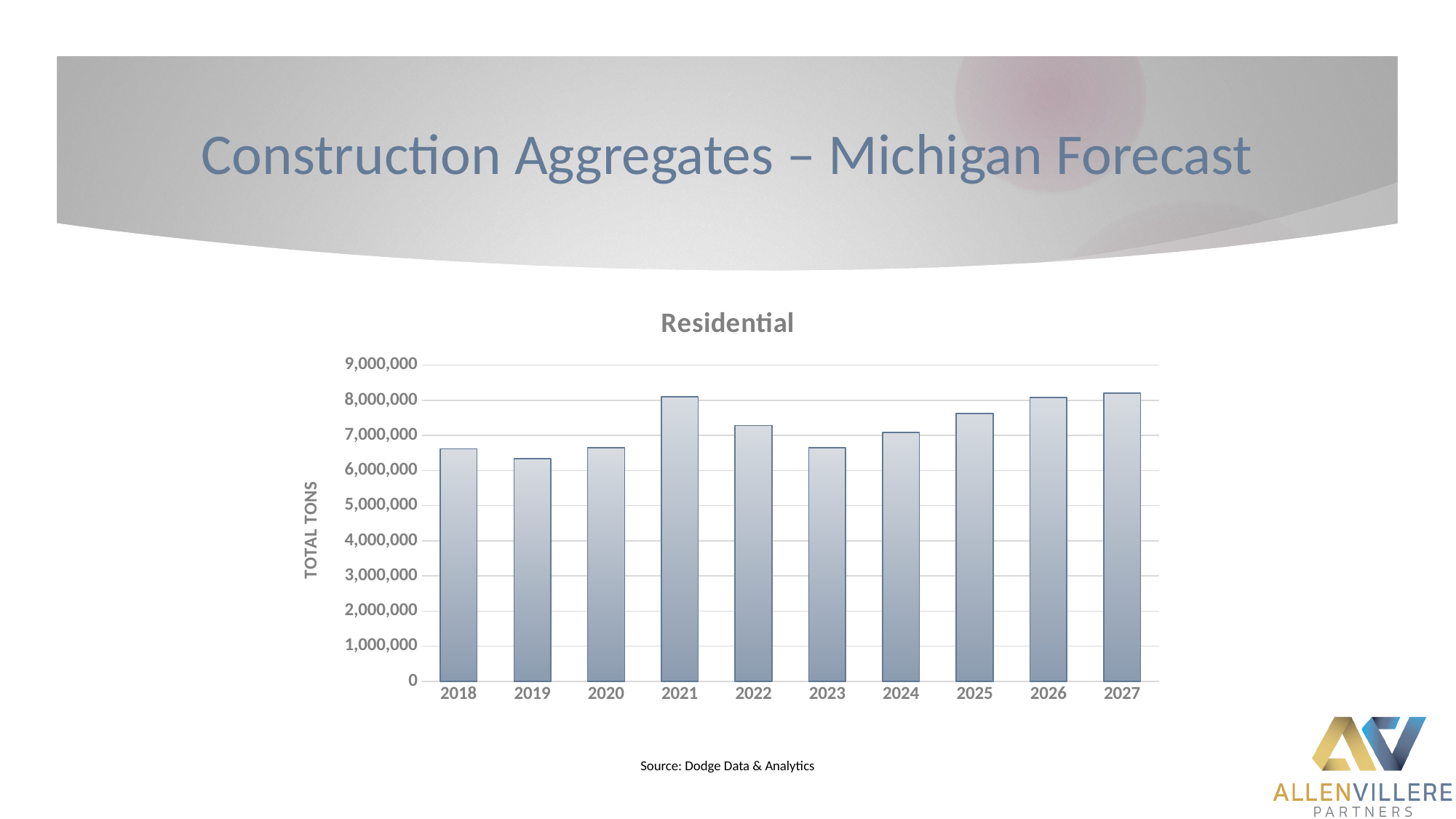
Is the value for 2025 greater or less than 7,000,000? greater Is the value for 2027 greater or less than 8,000,000? greater Is the value for 2019 greater or less than 7,000,000? less Do the values rise or fall from 2023 to 2027? rise Which is larger, the value for 2021 or the value for 2022? 2021 Which year has the lowest value in the Residential chart? 2019 Which is larger, the value for 2019 or the value for 2020? 2020 What is the label on the vertical axis of the chart? TOTAL TONS What kind of chart is shown on the slide? bar chart How many years are plotted on the x axis of the Residential chart? 10